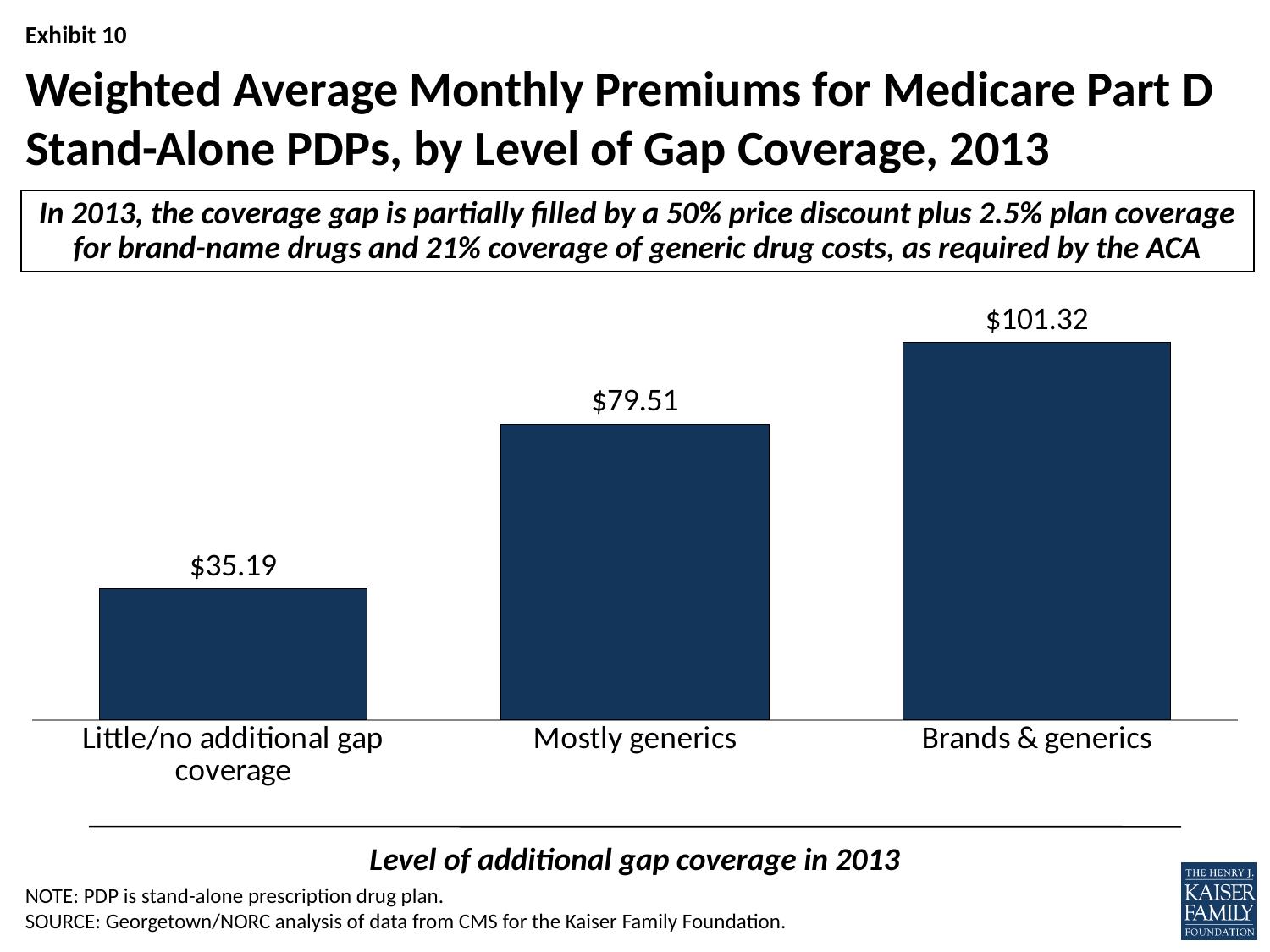
Which level of gap coverage has the highest weighted average monthly premium? Brands & generics What is the x-axis title of the chart? Level of additional gap coverage in 2013 Which level of gap coverage has the lowest weighted average monthly premium? Little/no additional gap coverage Do the monthly premiums rise or fall as the level of additional gap coverage increases from left to right? Rise What type of chart is shown on the slide? Bar chart How many levels of gap coverage are shown in the chart? 3 What is the weighted average monthly premium for plans with brands & generics gap coverage? $101.32 What is the difference in monthly premium between mostly generics plans and little/no additional gap coverage plans? $44.32 What is the weighted average monthly premium for plans with mostly generics gap coverage? $79.51 Which has a higher monthly premium: mostly generics or little/no additional gap coverage? Mostly generics What is the weighted average monthly premium for plans with little/no additional gap coverage? $35.19 What is the difference in monthly premium between brands & generics plans and mostly generics plans? $21.81